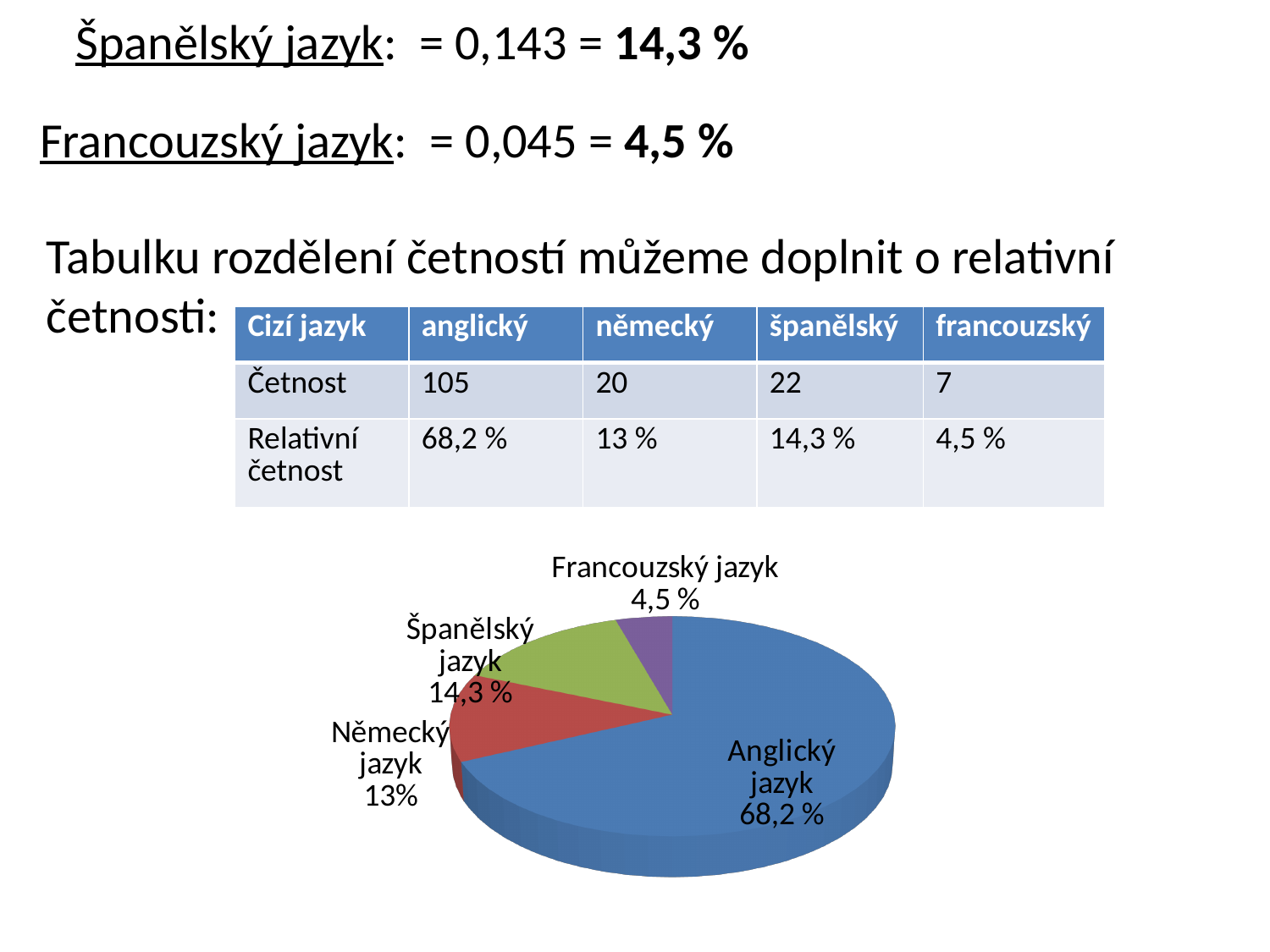
Which slice of the pie chart is the smallest? Francouzský jazyk How many slices does the pie chart have? 4 What colour is the Anglický jazyk slice in the pie chart? blue What is the difference between the shares of Španělský jazyk and Francouzský jazyk? 9,8 % What share of the pie does Německý jazyk have? 13% What share of the pie does Španělský jazyk have? 14,3 % Which slice of the pie chart is the largest? Anglický jazyk What share of the pie does Francouzský jazyk have? 4,5 % What kind of chart is shown on the slide? pie chart What is the difference between the shares of Anglický jazyk and Španělský jazyk? 53,9 % Which slice is larger, Španělský jazyk or Francouzský jazyk? Španělský jazyk